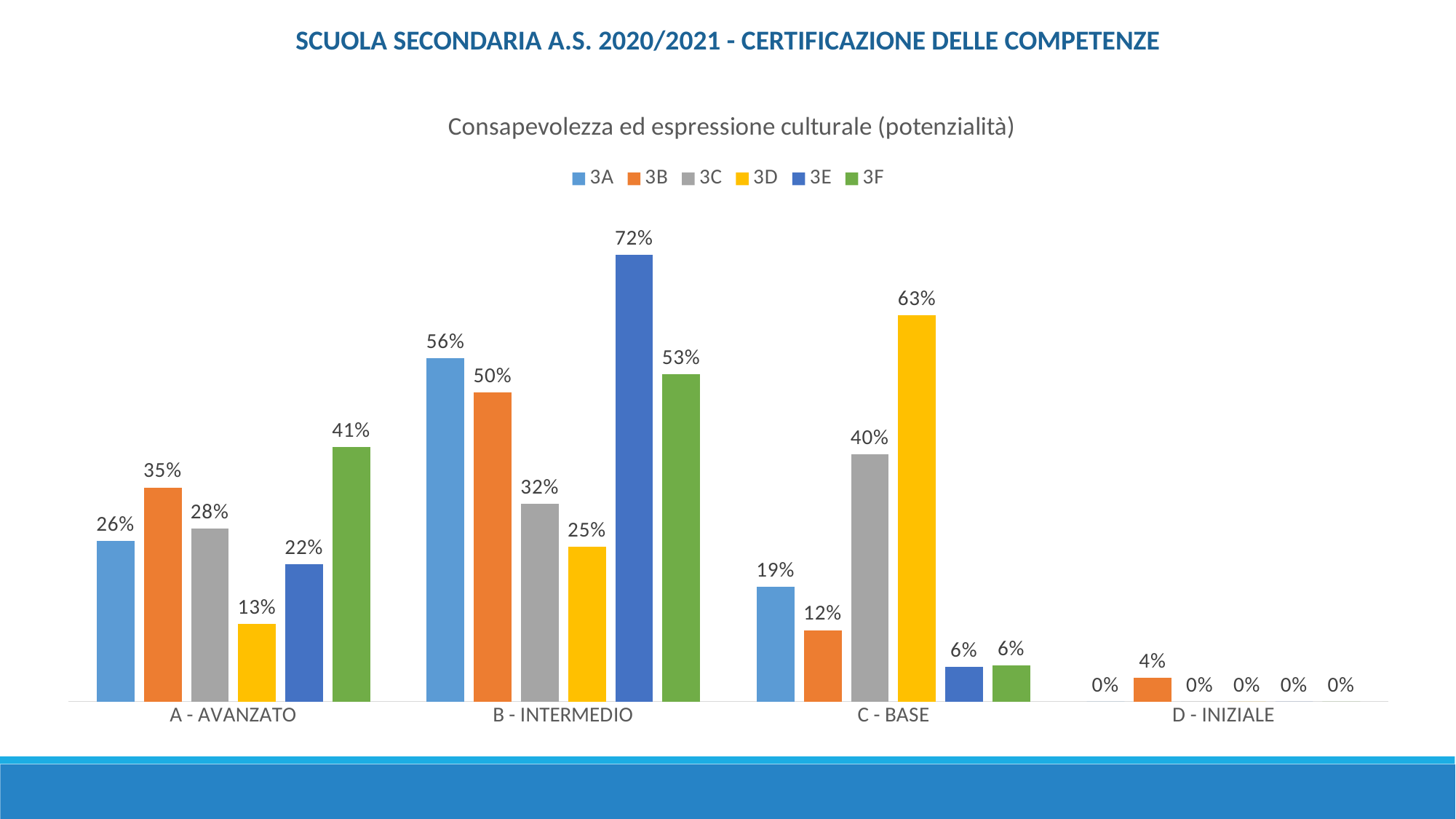
Which series has the highest value in the C - BASE category? 3D What is the value for 3D in the A - AVANZATO category? 13% What is the difference between the 3A and 3B values in the B - INTERMEDIO category? 6% What is the title of the chart? Consapevolezza ed espressione culturale (potenzialità) How many series does the legend list? 6 What is the value for 3F in the C - BASE category? 6% How many categories are shown on the x axis? 4 Which series has the lowest value in the A - AVANZATO category? 3D What kind of chart is shown on the slide? Bar chart What is the value for 3E in the B - INTERMEDIO category? 72% Which is larger in the A - AVANZATO category: the value for 3F or the value for 3B? 3F Which series has a non-zero value in the D - INIZIALE category? 3B